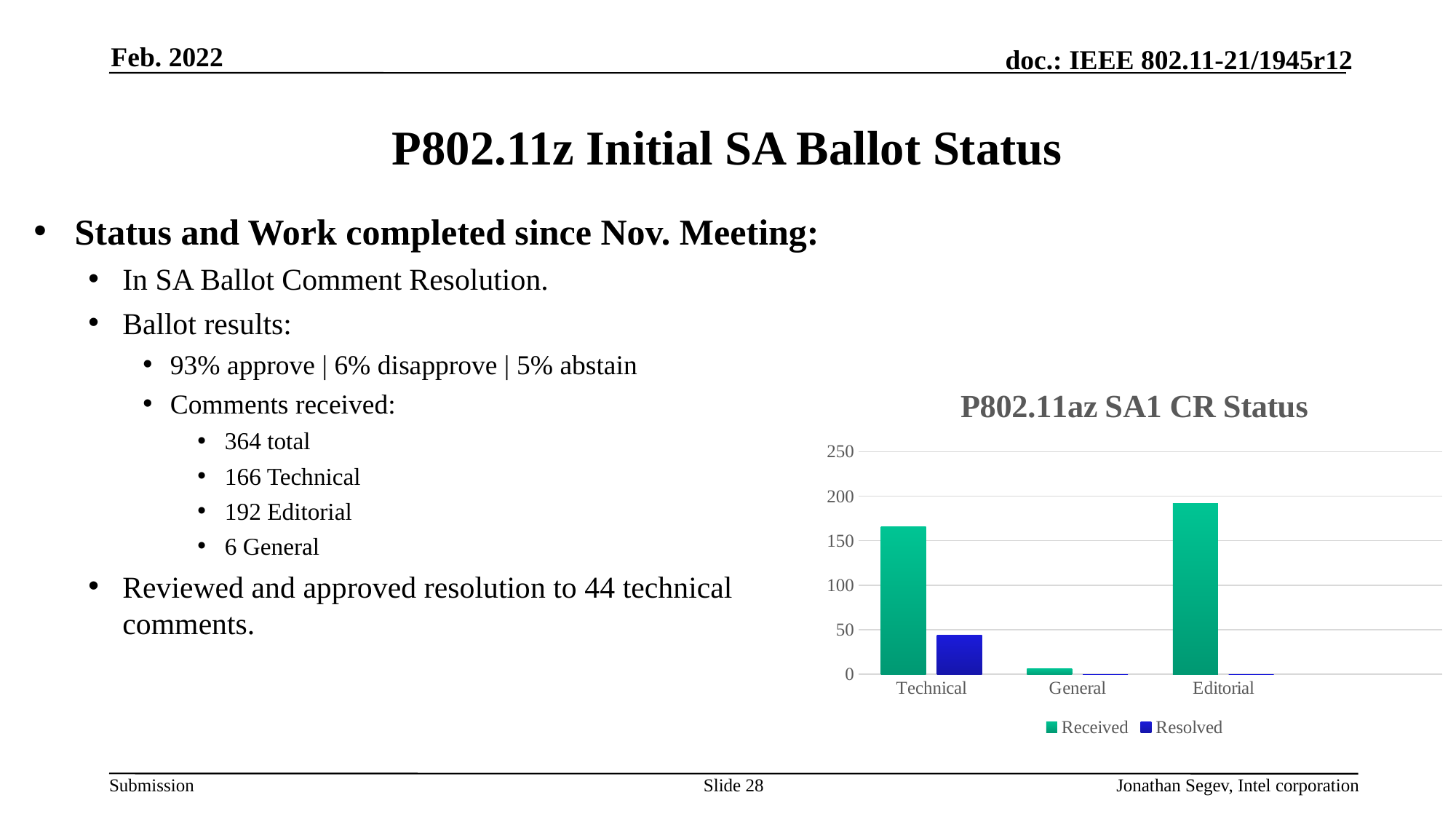
Which category has the highest Received value? Editorial Is the Received value for Technical greater or less than 150? greater How many series does the chart legend list? 2 How many categories are shown on the x axis of the chart? 3 What kind of chart is shown on the slide? bar chart Which category has the highest Resolved value? Technical Is the Received value for Editorial greater or less than 200? less Which is larger, the Received value for Editorial or the Received value for Technical? Editorial What is the title of the chart? P802.11az SA1 CR Status Which category has the lowest Received value? General Is the Resolved value for Technical greater or less than 50? less Which series is shown in blue in the chart legend? Resolved